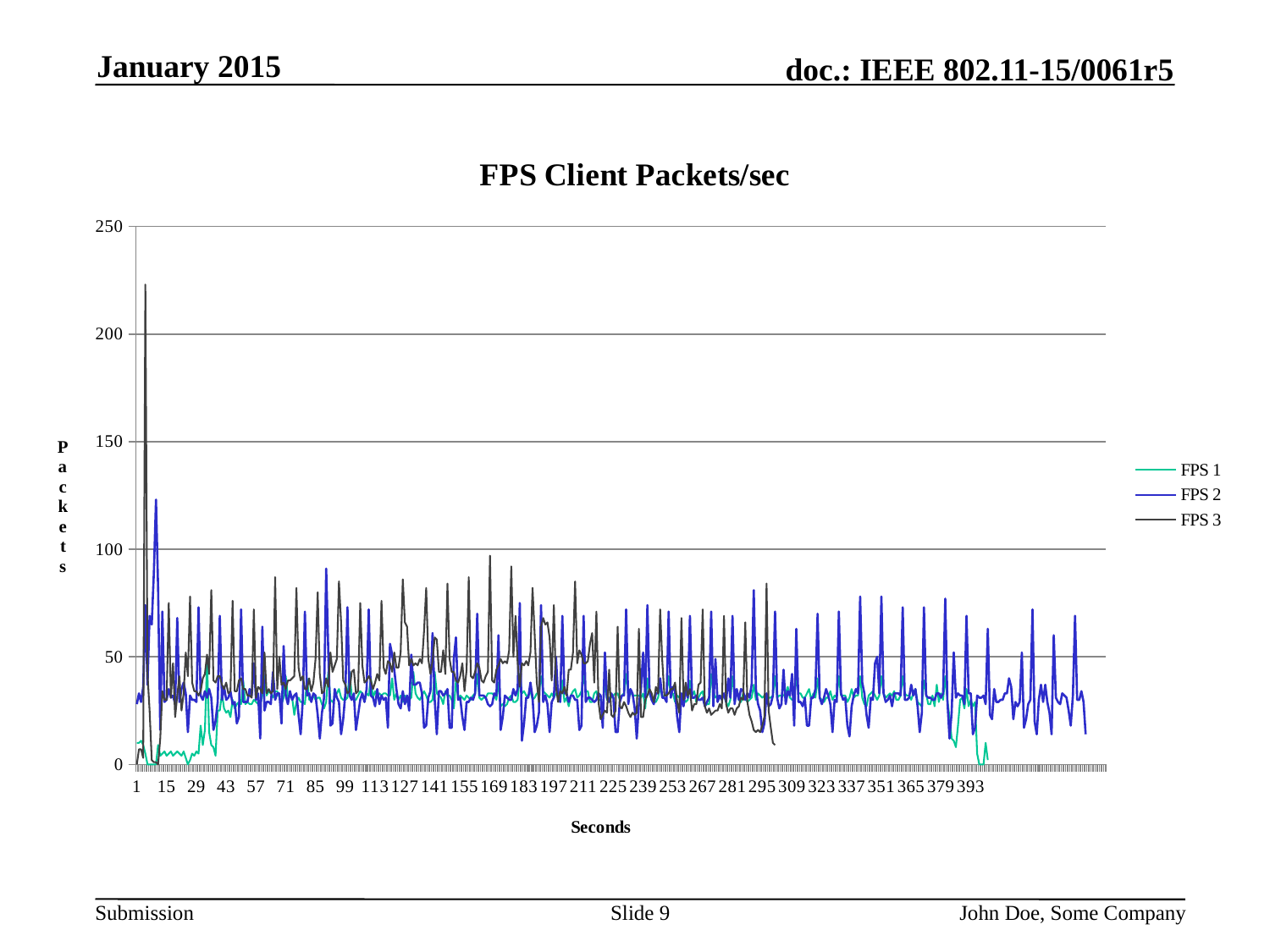
What kind of chart is shown on the slide? line chart What are the names of the series listed in the legend? FPS 1, FPS 2, FPS 3 Which series reaches a higher peak, FPS 1 or FPS 2? FPS 2 Is the highest value of FPS 2 greater or less than 150? less Which series reaches the highest peak value on the chart? FPS 3 How many series does the legend list? 3 Which series ends earliest along the x axis? FPS 3 Is the highest value of FPS 3 greater or less than 200? greater Is the highest value of FPS 2 greater or less than 100? greater What is the title of the chart? FPS Client Packets/sec Which series reaches a higher peak, FPS 2 or FPS 3? FPS 3